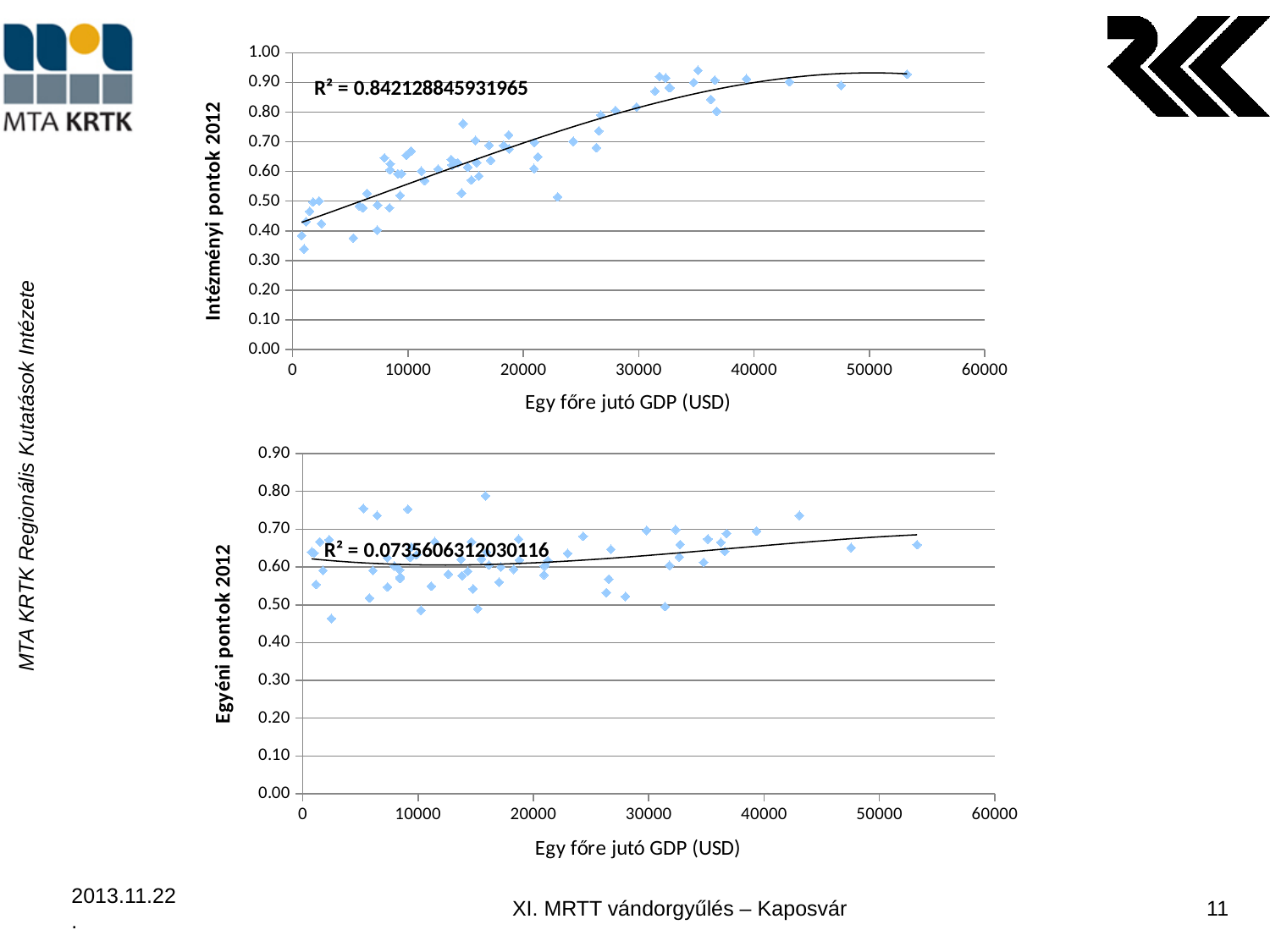
In the top chart (Intézményi pontok 2012), do the plotted values generally rise or fall as GDP per capita increases? rise What kind of chart is the top chart on the slide? scatter chart In the bottom chart (Egyéni pontok 2012), is the value for the point at roughly 53000 USD GDP per capita greater or less than 0.80? less What R² value is printed on the top chart (Intézményi pontok 2012)? R² = 0.842128845931965 What is the maximum value shown on the x axis of the top chart (Intézményi pontok 2012)? 60000 What kind of chart is the bottom chart on the slide? scatter chart Which chart has the higher R² value, the top chart (Intézményi pontok 2012) or the bottom chart (Egyéni pontok 2012)? the top chart (Intézményi pontok 2012) In the top chart (Intézményi pontok 2012), is the value for the point at roughly 53000 USD GDP per capita greater or less than 0.80? greater In the bottom chart (Egyéni pontok 2012), is the lowest plotted point greater or less than 0.50? less What R² value is printed on the bottom chart (Egyéni pontok 2012)? R² = 0.0735606312030116 What is the maximum value shown on the y axis of the bottom chart (Egyéni pontok 2012)? 0.90